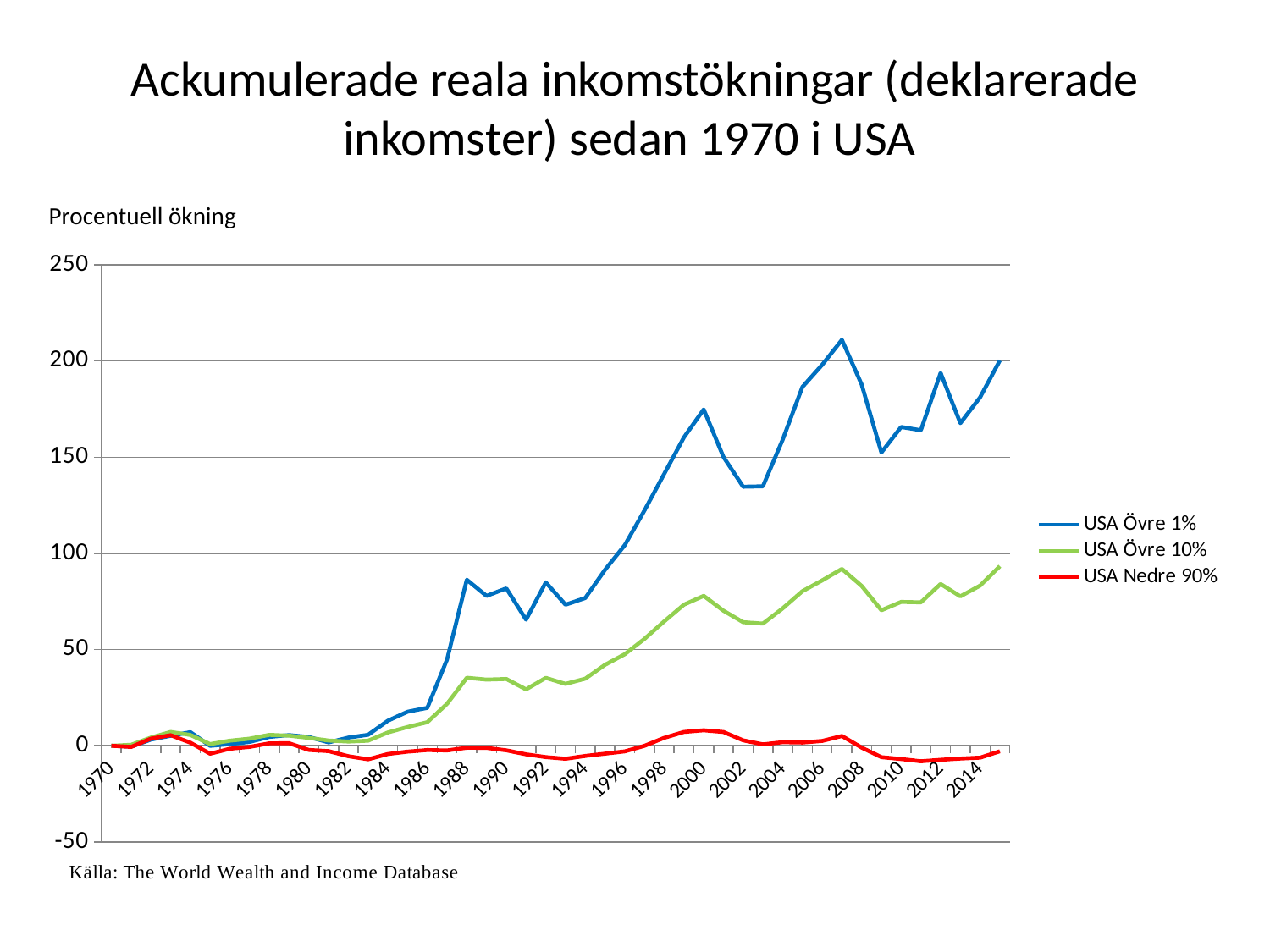
What is the source given below the chart? The World Wealth and Income Database Is the value for USA Övre 1% in 2002 greater or less than 150? less How many series does the legend list? 3 Is the value for USA Övre 10% in 2000 greater or less than 50? greater Is the value for USA Övre 10% in 2014 greater or less than 100? less Which series has the highest value in 2014? USA Övre 1% Which is larger in 2000: the value for USA Övre 1% or USA Övre 10%? USA Övre 1% Which series has the lowest value in 2014? USA Nedre 90% Does the USA Övre 1% series overall rise or fall from 1970 to 2014? rise What kind of chart is shown on the slide? line chart